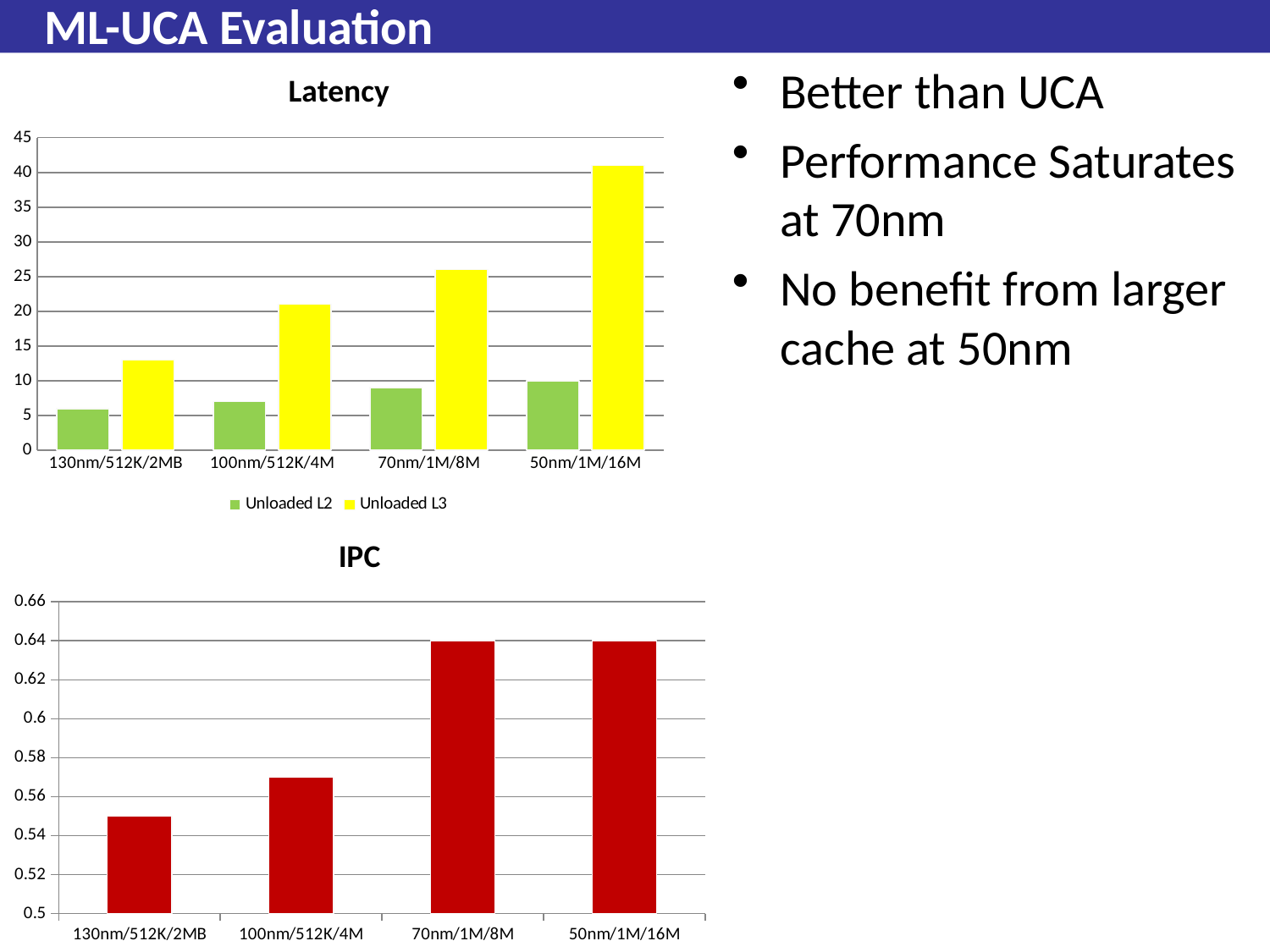
In the IPC chart, do the values rise or fall from 130nm/512K/2MB to 70nm/1M/8M? rise In the Latency chart, which configuration has the lowest Unloaded L3 latency? 130nm/512K/2MB What type of chart is the Latency chart? bar chart In the Latency chart, is the Unloaded L3 value for 130nm/512K/2MB greater or less than 10? greater How many series does the legend of the Latency chart list? 2 In the Latency chart, which configuration has the highest Unloaded L3 latency? 50nm/1M/16M How many configurations are shown on the x axis of the Latency chart? 4 In the Latency chart, is the Unloaded L3 value for 50nm/1M/16M greater or less than 35? greater What are the two series named in the legend of the Latency chart? Unloaded L2 and Unloaded L3 In the IPC chart, which configuration has the lowest IPC? 130nm/512K/2MB In the IPC chart, is the value for 100nm/512K/4M greater or less than 0.56? greater In the Latency chart, for 70nm/1M/8M, which is larger: Unloaded L2 or Unloaded L3? Unloaded L3